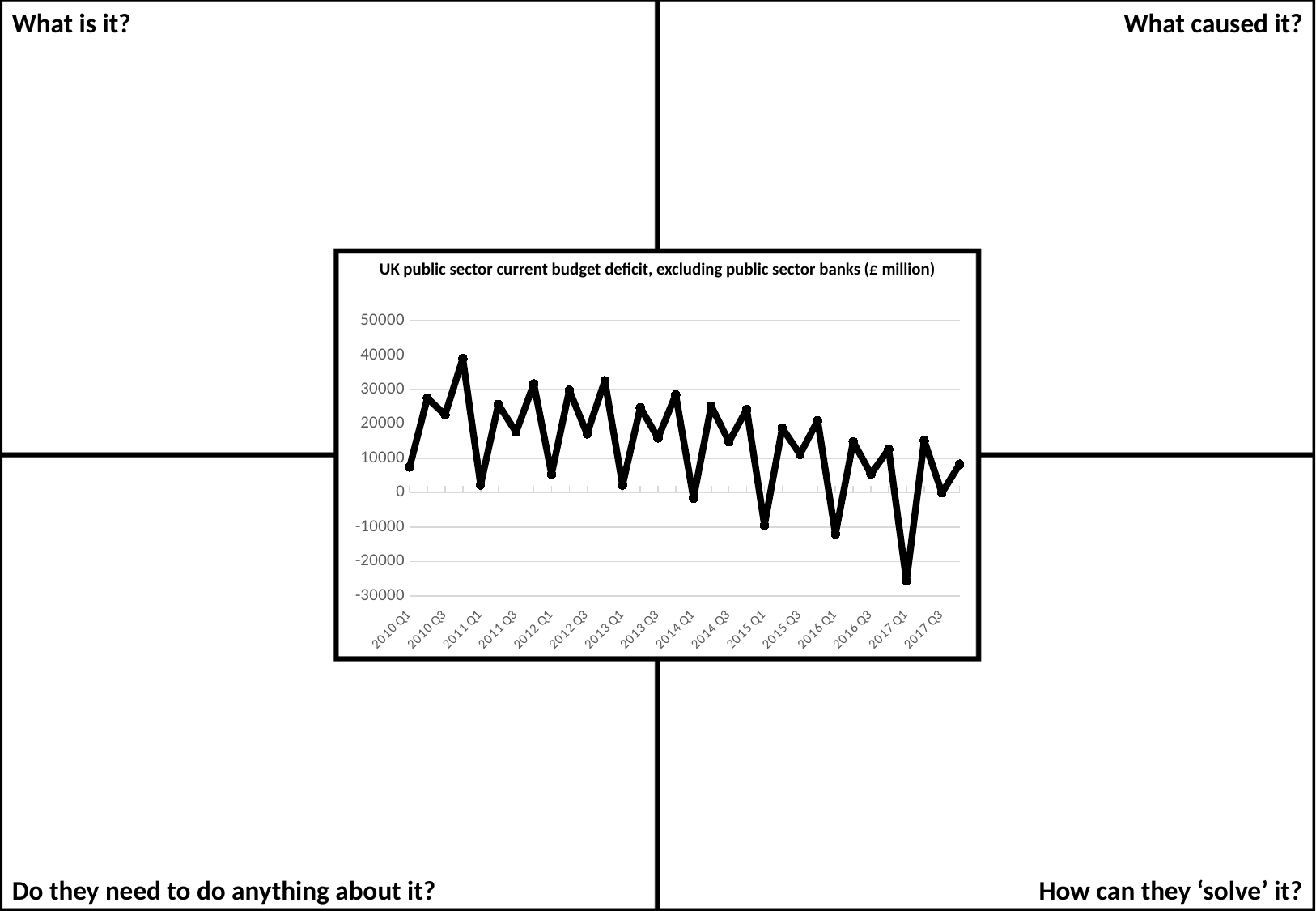
Is the value for 2017 Q1 greater or less than -20000? less Is the value for 2011 Q1 greater or less than 30000? less Is the value for 2012 Q1 greater or less than 30000? less Which quarter has the lowest value on the chart? 2017 Q1 What type of chart is shown on the slide? line chart Which is larger, the value for 2011 Q1 or the value for 2010 Q1? 2010 Q1 Overall, do the values rise or fall from 2010 Q1 to 2017 Q3? fall Which is larger, the value for 2016 Q1 or the value for 2017 Q1? 2016 Q1 Which quarter has the highest value on the chart? 2010 Q4 What is the title of the chart? UK public sector current budget deficit, excluding public sector banks (£ million)